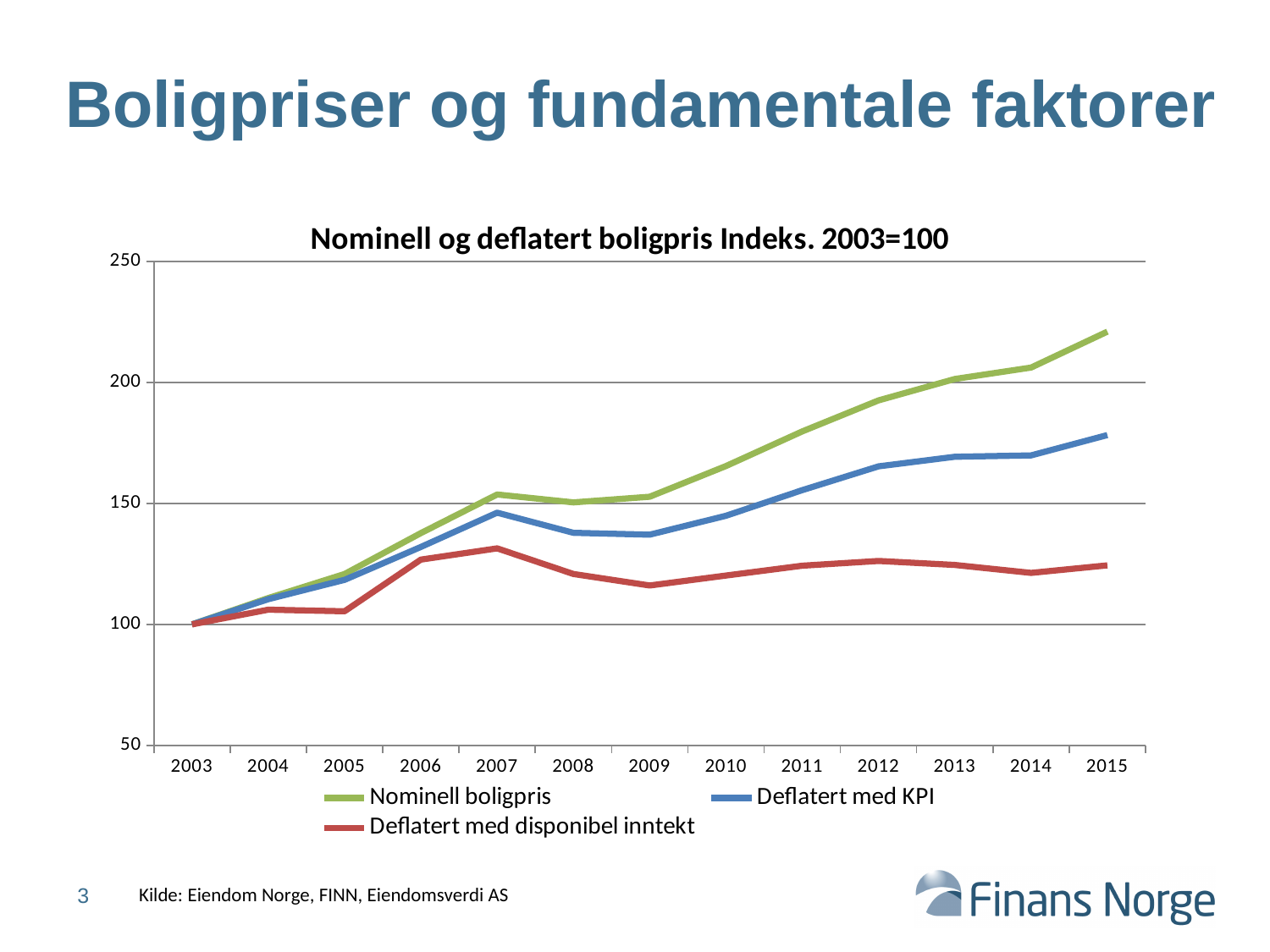
Is the value for Nominell boligpris in 2015 greater or less than 200? greater Which series has the lowest value in 2015? Deflatert med disponibel inntekt Does Nominell boligpris rise or fall from 2003 to 2015? rise How many years are plotted along the x axis? 13 Which series has the highest value in 2015? Nominell boligpris What kind of chart is shown on the slide? line chart What is the value of Nominell boligpris in 2003? 100 Is the value for Deflatert med KPI in 2015 greater or less than 200? less How many series does the legend list? 3 Is the value for Deflatert med KPI in 2009 greater or less than 150? less In 2012, which is larger: Nominell boligpris or Deflatert med disponibel inntekt? Nominell boligpris